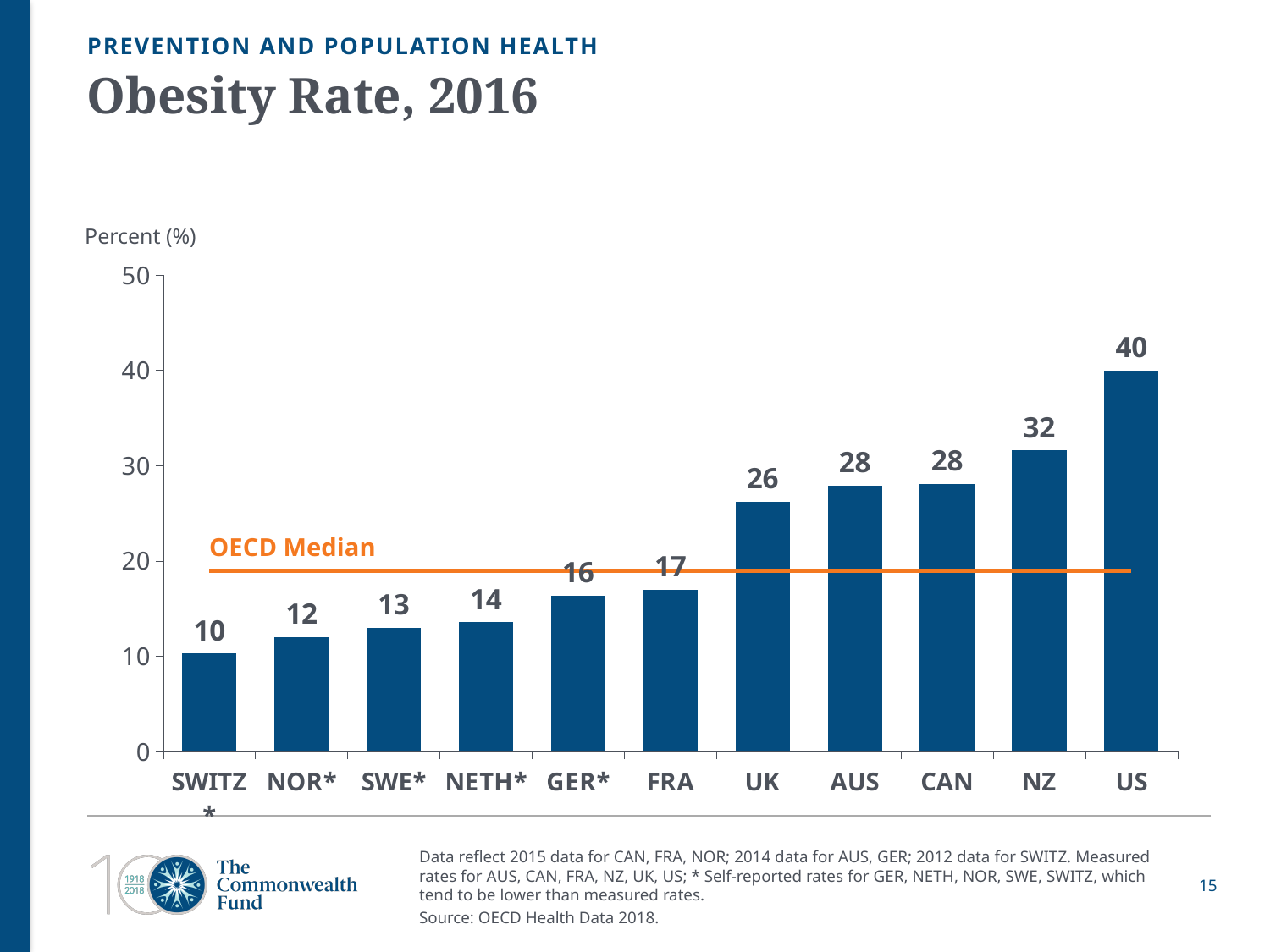
What is the obesity rate shown for FRA? 17 Is the value for the OECD Median line greater or less than 20? less What is the obesity rate shown for NETH*? 14 What kind of chart is shown on the slide? Bar chart What is the difference between the obesity rates of the US and NZ? 8 Do the obesity rates rise or fall moving from left to right along the x axis? Rise Which country has the lowest obesity rate on the chart? SWITZ* Which has a higher obesity rate, UK or GER*? UK How many countries are shown on the chart? 11 What is the label of the orange horizontal line on the chart? OECD Median What is the obesity rate shown for the US? 40 Which country has the highest obesity rate on the chart? US